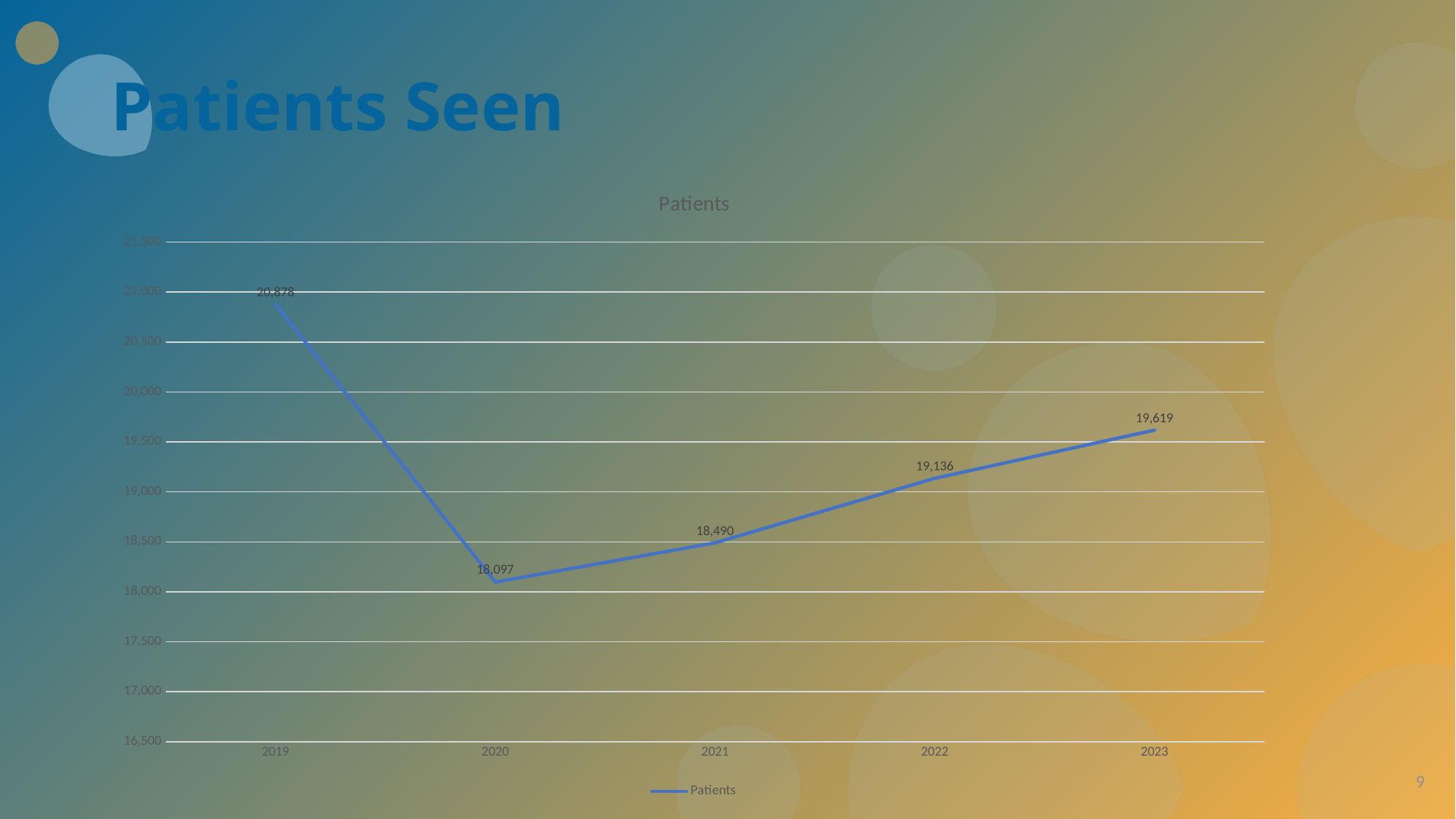
Which year has the lowest number of patients? 2020 What is the value for 2020? 18,097 Do the values rise or fall from 2020 to 2023? Rise What is the value for 2022? 19,136 What kind of chart is shown? Line chart Which year has the highest number of patients? 2019 What is the value for 2021? 18,490 What is the difference between the values for 2019 and 2020? 2,781 What is the value for 2023? 19,619 How many years are plotted on the chart? 5 Which is larger, the value for 2021 or the value for 2022? 2022 What is the value for 2019? 20,878